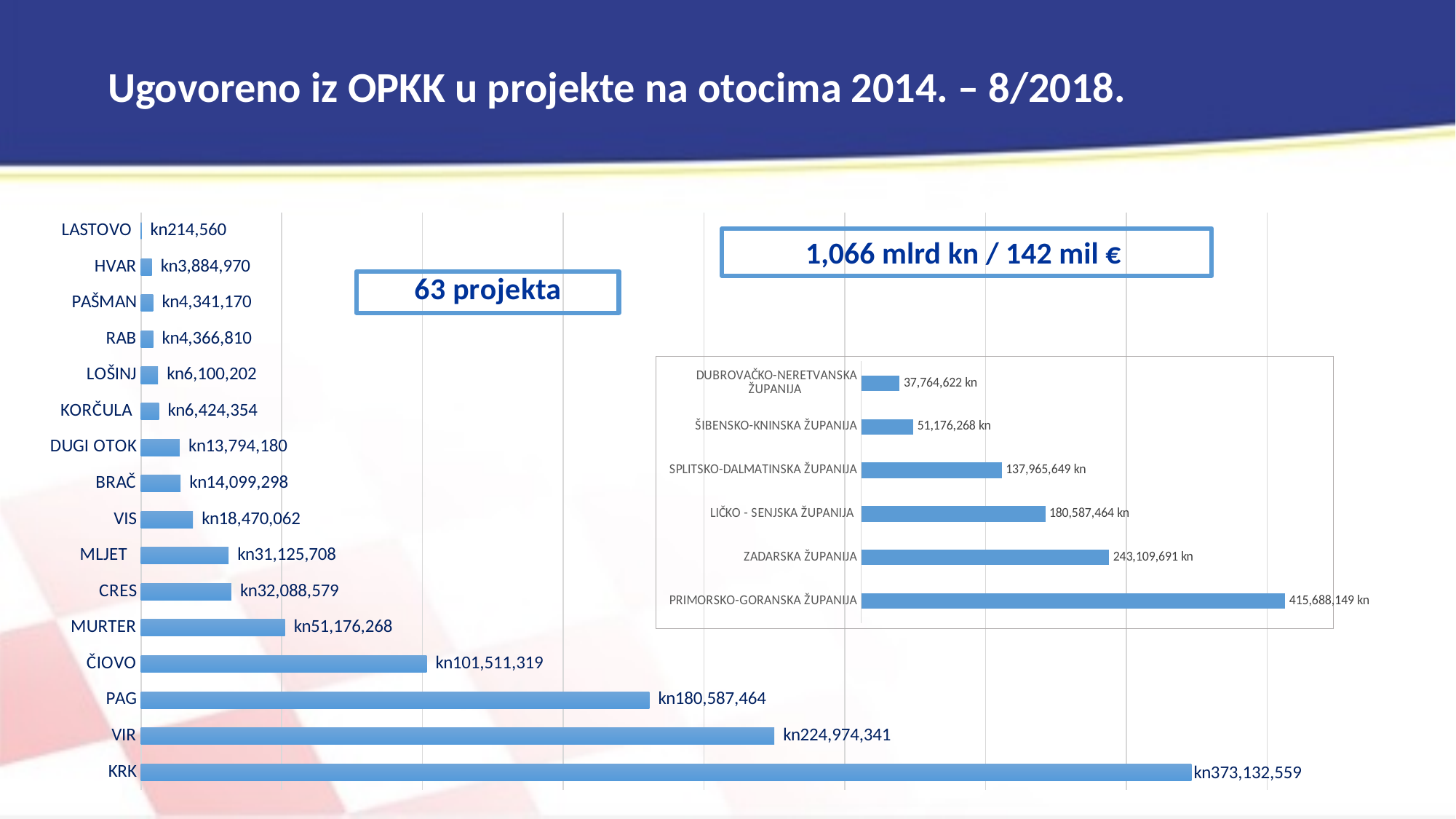
In the left chart of islands, which island has the highest value? KRK In the right chart of counties (županije), what is the value for ZADARSKA ŽUPANIJA? 243,109,691 kn In the left chart of islands, what is the difference between the values for KRK and VIR? kn148,158,218 In the left chart of islands, what is the value for MLJET? kn31,125,708 In the right chart of counties (županije), which county has the lowest value? DUBROVAČKO-NERETVANSKA ŽUPANIJA In the left chart of islands, which has the larger value, PAG or ČIOVO? PAG What type of chart is the right chart of counties (županije)? Bar chart In the left chart of islands, what is the value for KRK? kn373,132,559 In the left chart of islands, which island has the lowest value? LASTOVO In the right chart of counties (županije), how many counties are shown? 6 In the right chart of counties (županije), which county has the highest value? PRIMORSKO-GORANSKA ŽUPANIJA In the left chart of islands, how many islands are listed? 16